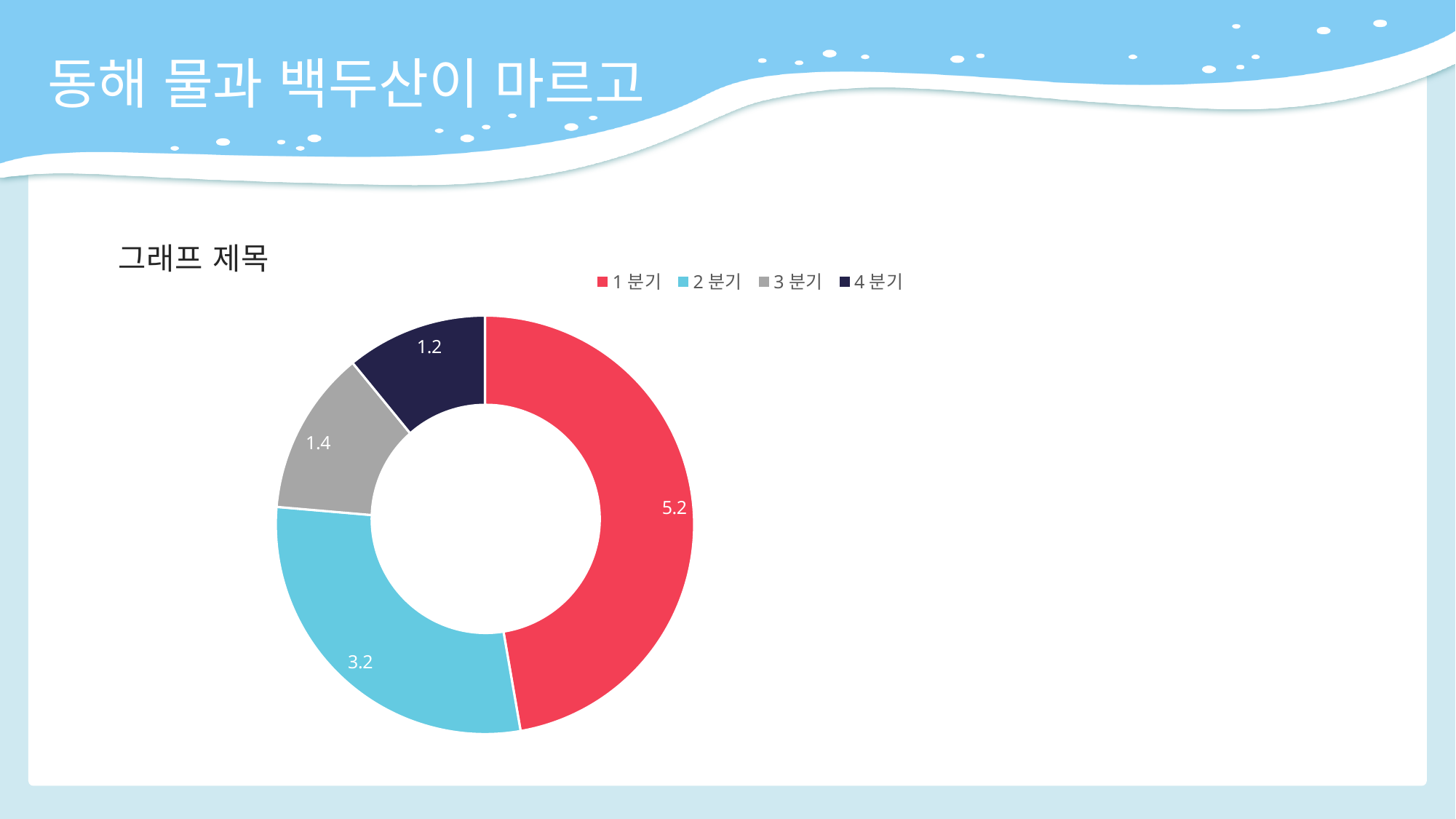
What is the title of the chart? 그래프 제목 What is the total of all the values in the chart? 11 What kind of chart is shown on the slide? doughnut chart What is the value for 1 분기 in the chart? 5.2 What is the value for 2 분기 in the chart? 3.2 How many categories are shown in the chart? 4 What is the difference between the values for 1 분기 and 2 분기? 2 What is the value for 3 분기 in the chart? 1.4 What is the value for 4 분기 in the chart? 1.2 Which category has the smallest value in the chart? 4 분기 Which category has the largest value in the chart? 1 분기 Which is larger, the value for 2 분기 or the value for 3 분기? 2 분기